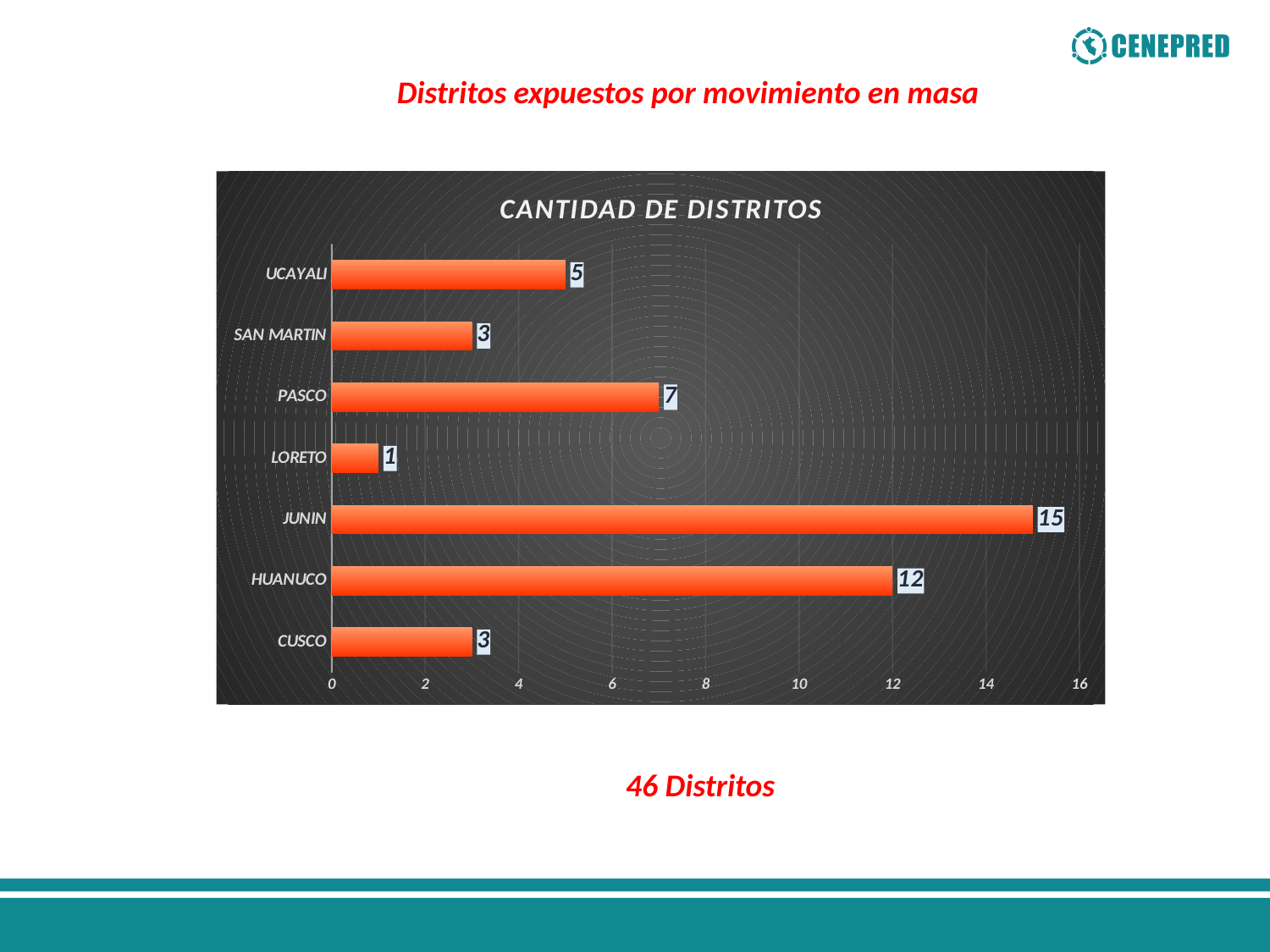
Is the value for HUANUCO greater or less than 10? greater What is the value for JUNIN? 15 What is the title of the chart? CANTIDAD DE DISTRITOS What is the value for HUANUCO? 12 Which category has the lowest value? LORETO Which category has the highest value? JUNIN Which is larger, the value for UCAYALI or the value for PASCO? PASCO What is the difference between the values for JUNIN and HUANUCO? 3 What is the value for LORETO? 1 What kind of chart is shown? bar chart How many categories are shown in the chart? 7 What is the value for PASCO? 7